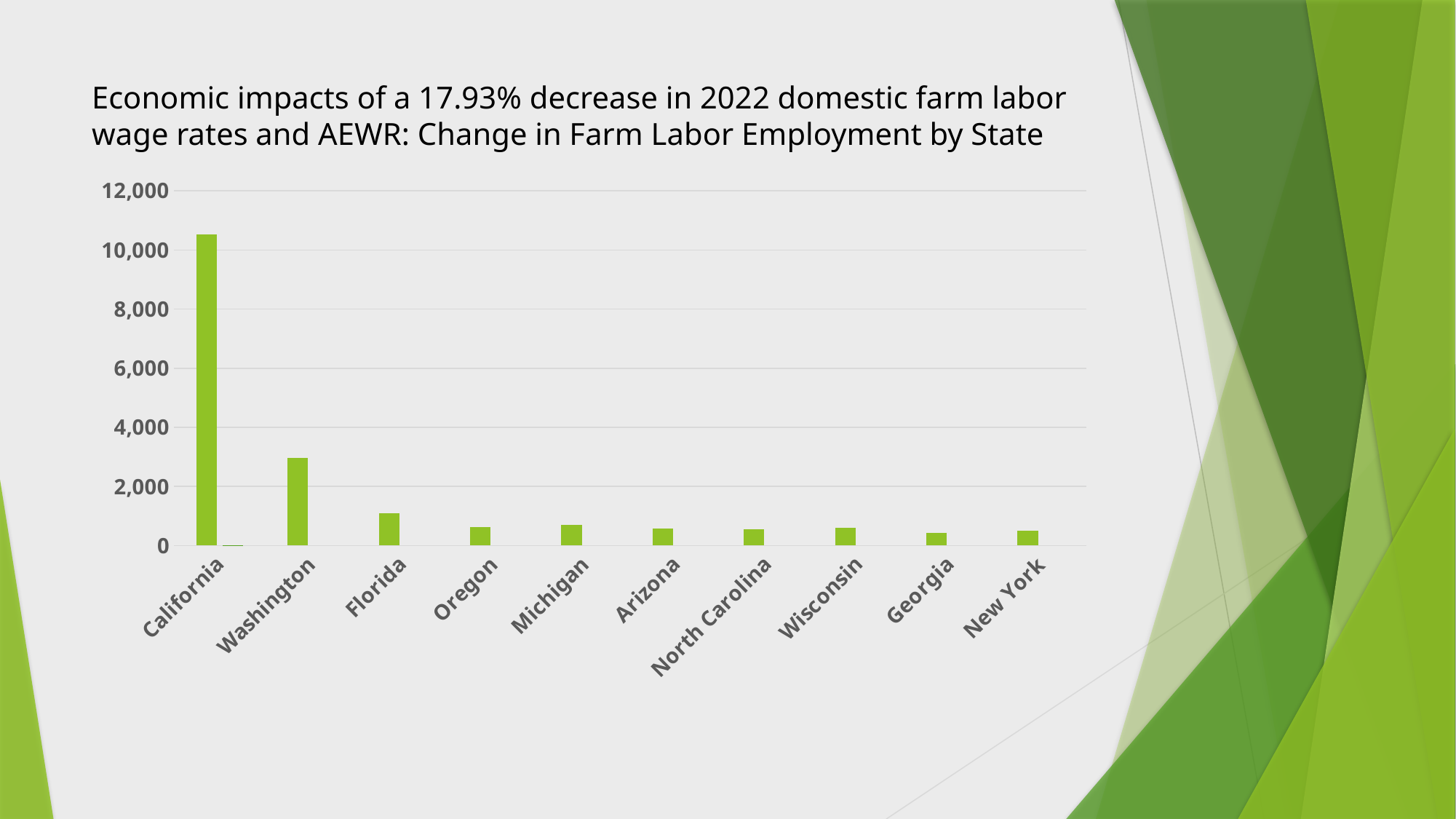
Is the value for California greater or less than 10,000? greater What is the highest value shown on the y axis of the chart? 12,000 Is the value for Florida greater or less than 2,000? less Do the values generally rise or fall moving from California on the left to New York on the right? fall Is the value for Washington greater or less than 2,000? greater How many states are shown on the x axis of the chart? 10 What colour are the bars in the chart? Green What kind of chart is shown on the slide? Bar chart Which is larger, the value for Washington or the value for Florida? Washington Which state has the highest change in farm labor employment? California Which is larger, the value for California or the value for Washington? California